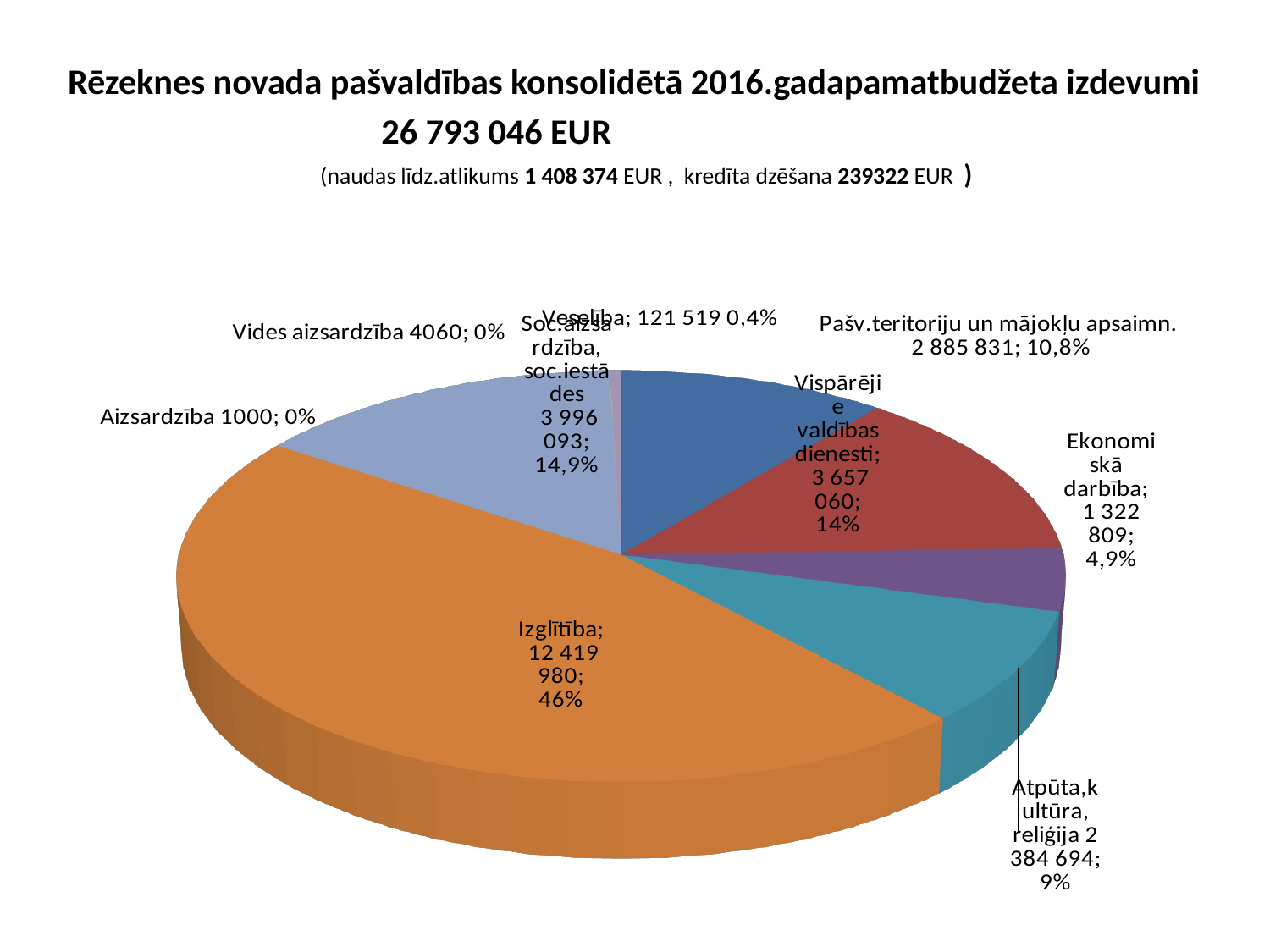
How many categories (slices) does the pie chart show? 9 What total amount in EUR is stated in the chart title? 26 793 046 EUR Which category has the largest slice of the pie? Izglītība What kind of chart is shown on the slide? Pie chart What share of the pie does Izglītība represent? 46% What is the value for Pašv.teritoriju un mājokļu apsaimn.? 2 885 831 Which category has the smallest value? Aizsardzība What is the value for Vispārējie valdības dienesti? 3 657 060 What percentage is shown for Soc.aizsardzība, soc.iestādes? 14,9% Which is larger: Pašv.teritoriju un mājokļu apsaimn. or Atpūta,kultūra, reliģija? Pašv.teritoriju un mājokļu apsaimn. What is the value for Izglītība? 12 419 980 What is the difference between the values for Vispārējie valdības dienesti and Ekonomiskā darbība? 2 334 251